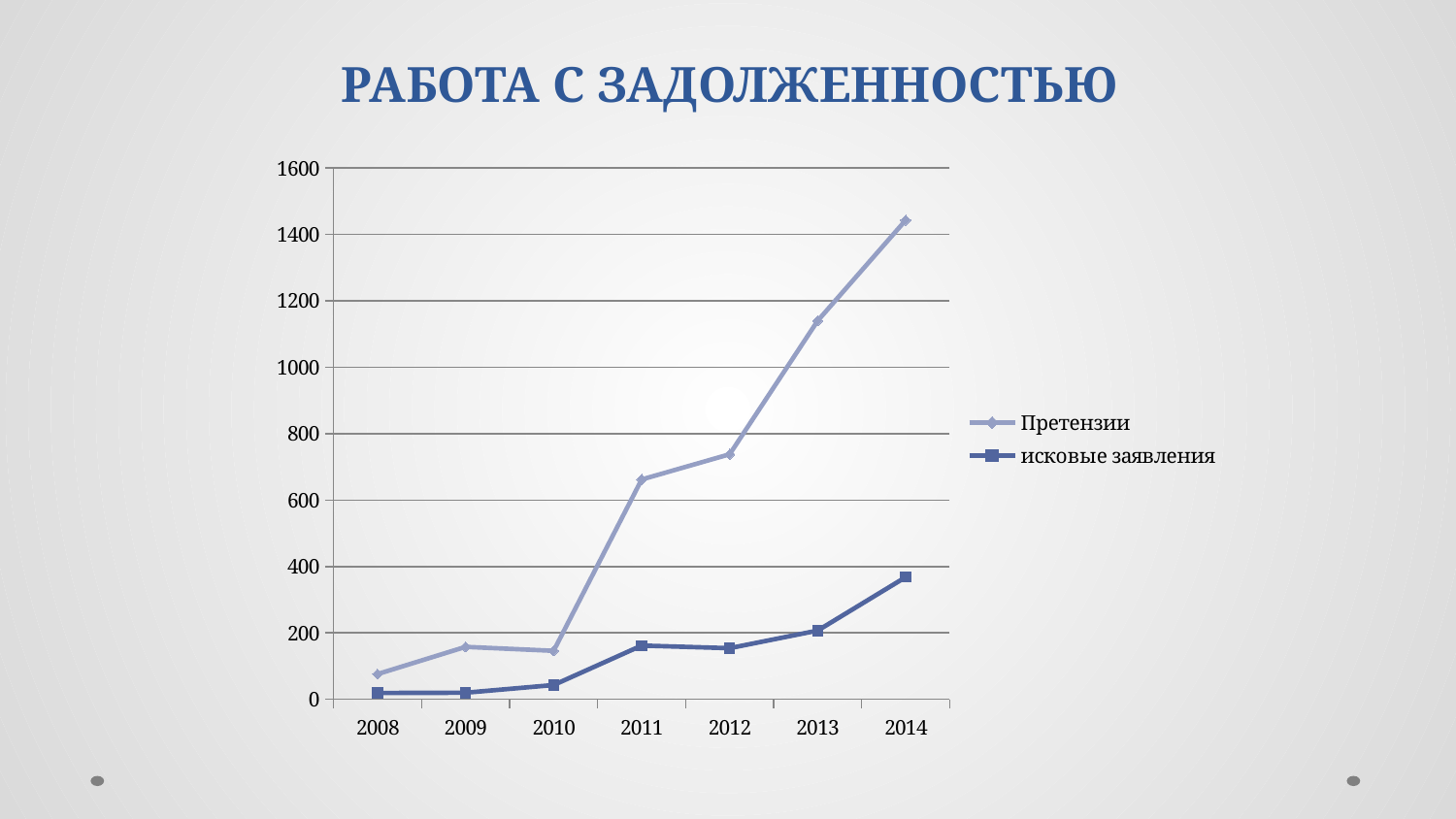
Do the values for Претензии generally rise or fall from 2008 to 2014? rise Is the value for исковые заявления in 2011 greater or less than 200? less How many years are plotted along the x axis? 7 In which year is the value for Претензии lowest? 2008 Is the value for Претензии in 2014 greater or less than 1400? greater In which year is the value for Претензии highest? 2014 Is the value for исковые заявления in 2014 greater or less than 400? less What kind of chart is shown on the slide? line chart How many series does the legend list? 2 Which series has the larger value in 2014, Претензии or исковые заявления? Претензии